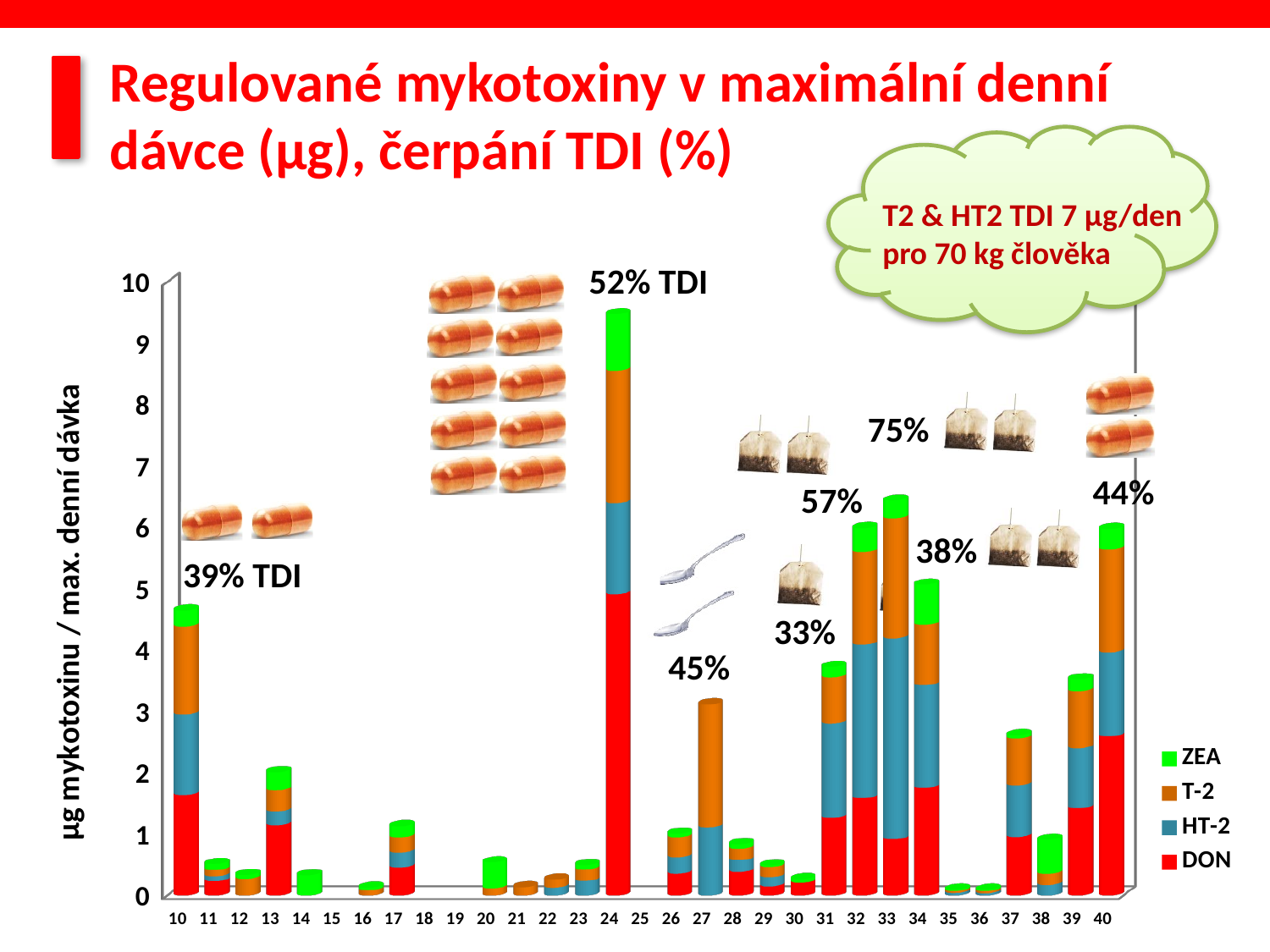
Which series are listed in the legend? ZEA, T-2, HT-2, DON Which has the larger total, category 32 or category 34? 32 What TDI percentage is annotated above the bar for category 33? 75% Is the total for category 35 greater or less than 1? less How many series does the legend list? 4 Which category has the tallest stacked bar? 24 What TDI percentage is annotated above the bar for category 24? 52% TDI Is the total for category 10 greater or less than 5? less Is the total for category 33 greater or less than 6? greater What kind of chart is shown on the slide? stacked bar chart How many categories are shown on the x axis? 31